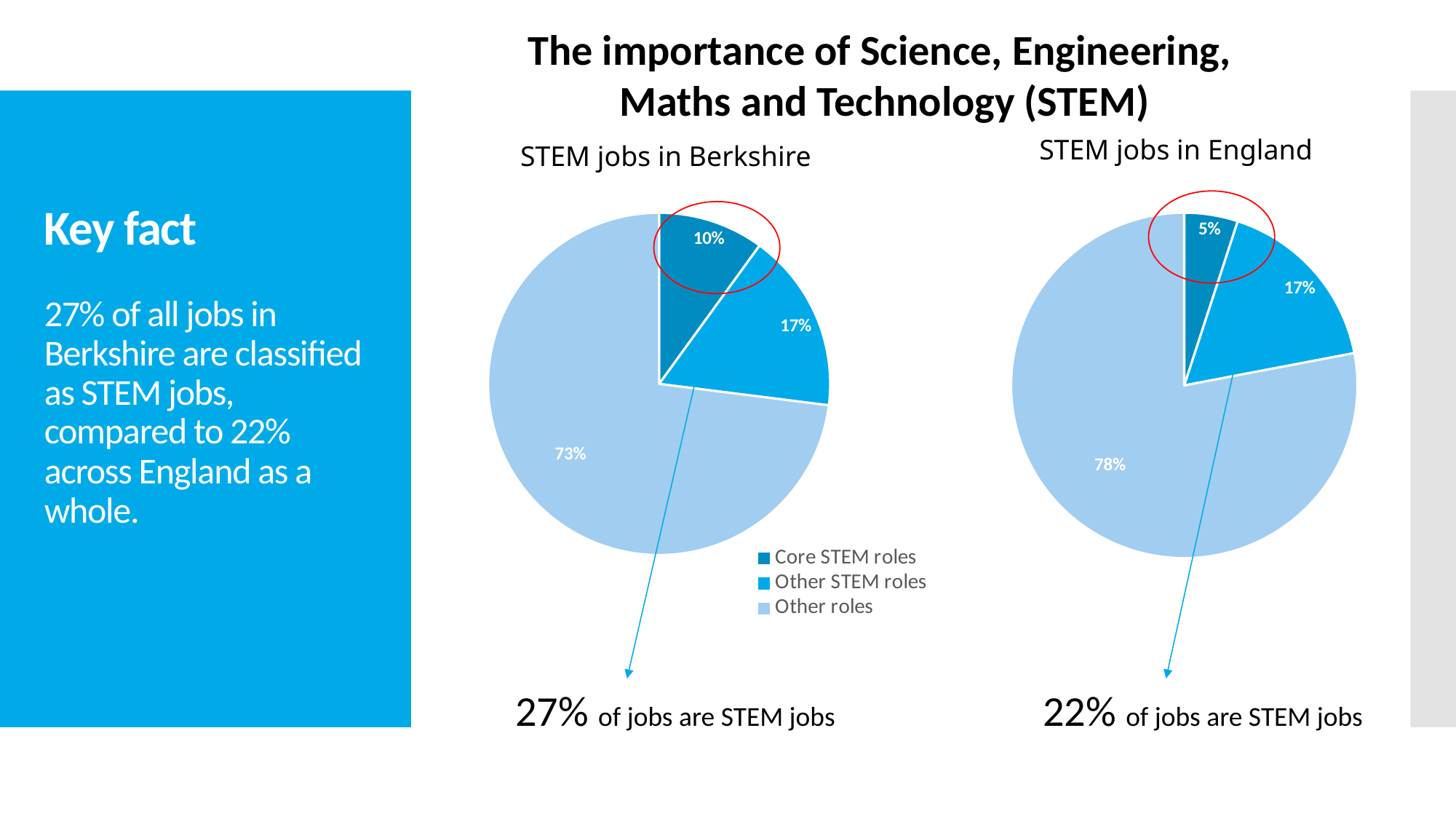
In the 'STEM jobs in England' chart, which category has the smallest slice? Core STEM roles In the 'STEM jobs in Berkshire' chart, what share of jobs are Other roles? 73% In the 'STEM jobs in England' chart, what share of jobs are Core STEM roles? 5% In the 'STEM jobs in England' chart, what share of jobs are Other STEM roles? 17% In the 'STEM jobs in Berkshire' chart, which category has the largest slice? Other roles In the 'STEM jobs in Berkshire' chart, what share of jobs are Core STEM roles? 10% What is the title of the pie chart on the right? STEM jobs in England In the 'STEM jobs in England' chart, what share of jobs are Other roles? 78% What is the difference between the Core STEM roles share in the 'STEM jobs in Berkshire' chart and in the 'STEM jobs in England' chart? 5% How many categories does the legend list for the pie charts? 3 Is the Other roles share larger in the 'STEM jobs in Berkshire' chart or the 'STEM jobs in England' chart? STEM jobs in England What type of chart is used for 'STEM jobs in Berkshire'? Pie chart